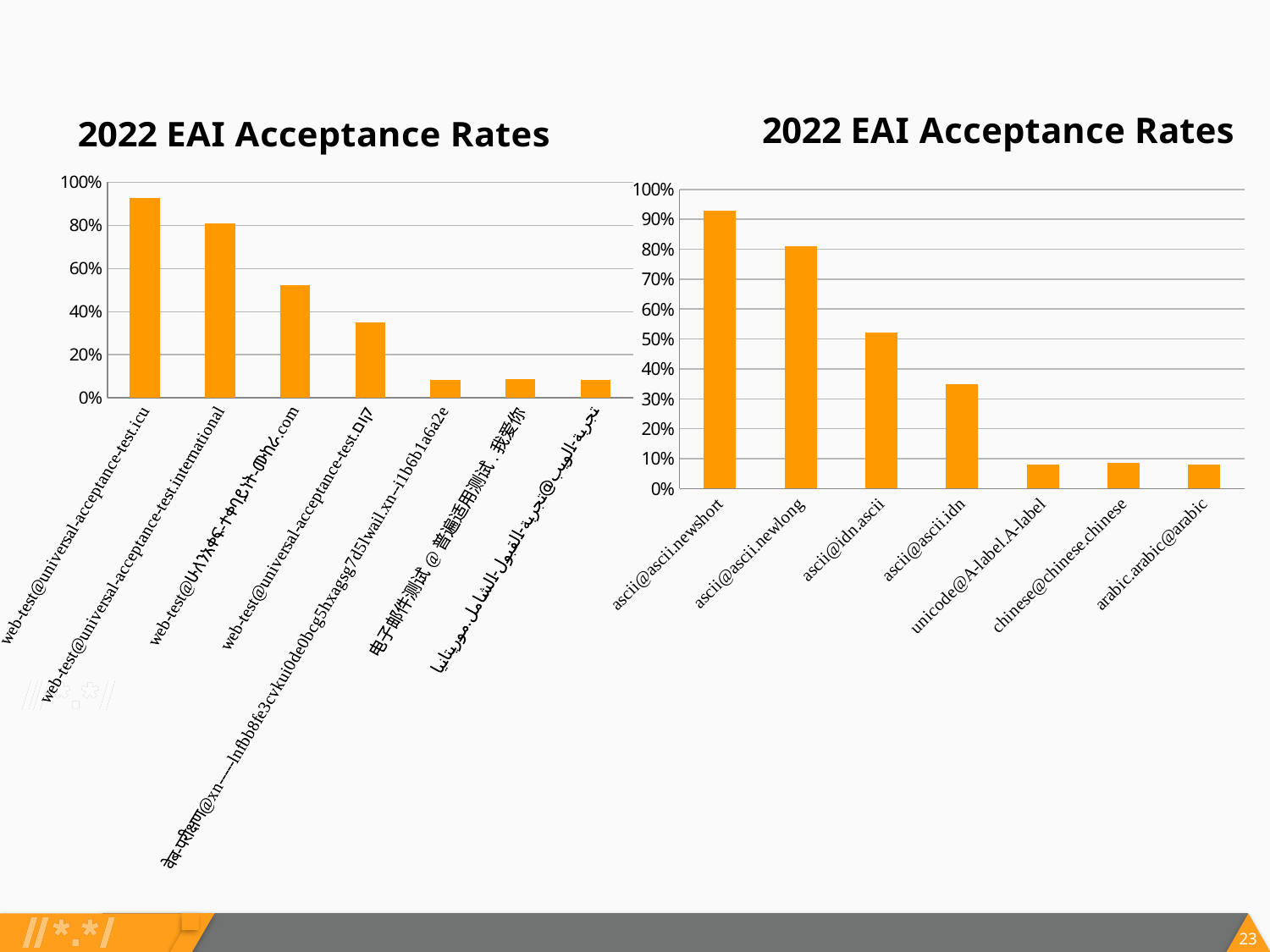
In the right chart, do the values rise or fall from left to right along the x axis? fall In the right chart, is the value for ascii@ascii.idn greater or less than 40%? less In the right chart, which category has the highest acceptance rate? ascii@ascii.newshort In the right chart, which is larger: the value for ascii@ascii.newshort or the value for ascii@ascii.newlong? ascii@ascii.newshort In the right chart, is the value for unicode@A-label.A-label greater or less than 10%? less How many bars does the left chart show? 7 How many bars does the right chart show? 7 In the right chart, is the value for ascii@idn.ascii greater or less than 60%? less What kind of chart is the left chart on the slide? bar chart In the left chart, which category has the highest acceptance rate? web-test@universal-acceptance-test.icu